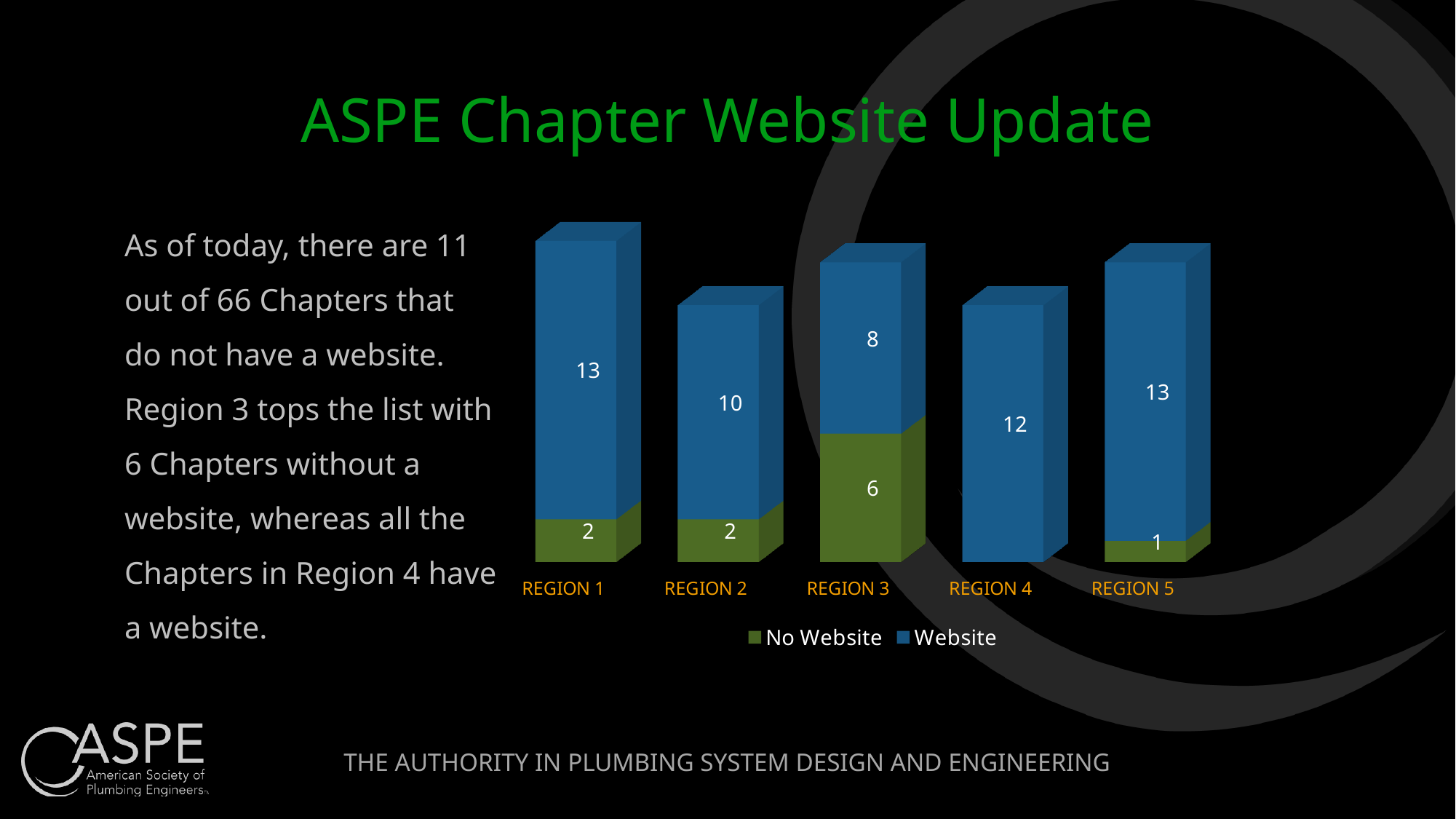
How many regions are shown on the x axis? 5 What is the No Website value for Region 5? 1 What kind of chart is shown on the slide? Stacked bar chart Which region has the highest No Website value? Region 3 How many chapters in Region 3 have no website? 6 What is the Website value for Region 2? 10 Which region has the lowest Website value? Region 3 Which is larger, the No Website value for Region 3 or for Region 1? Region 3 What colour represents the No Website series? Green What is the difference between the Website and No Website values for Region 3? 2 What is the total height of the stacked bar for Region 1? 15 How many series does the legend list? 2